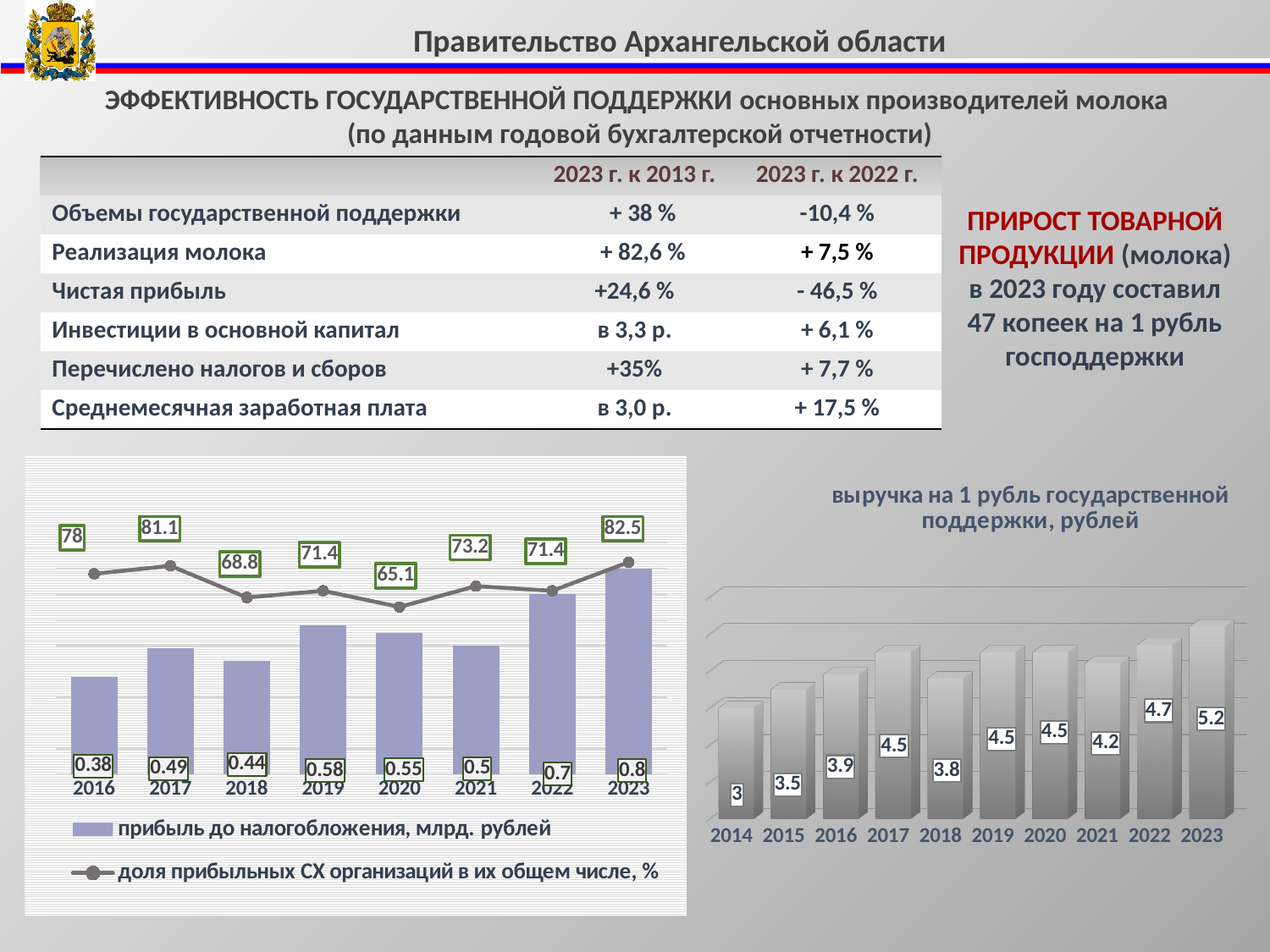
In the chart 'выручка на 1 рубль государственной поддержки, рублей', what is the value for 2018? 3.8 In the left chart, which year has the lowest 'доля прибыльных СХ организаций в их общем числе, %'? 2020 In the chart 'выручка на 1 рубль государственной поддержки, рублей', what is the difference between the values for 2023 and 2014? 2.2 In the chart 'выручка на 1 рубль государственной поддержки, рублей', is the value for 2022 larger or smaller than the value for 2021? larger How many series does the legend of the left chart list? 2 In the left chart, what is the value of 'доля прибыльных СХ организаций в их общем числе, %' for 2020? 65.1 In the left chart, what is the value of 'прибыль до налогообложения, млрд. рублей' for 2019? 0.58 In the left chart, what is the difference between the 'прибыль до налогообложения' values for 2023 and 2016? 0.42 In the chart 'выручка на 1 рубль государственной поддержки, рублей', how many years are shown? 10 In the left chart, which year has the highest 'прибыль до налогообложения, млрд. рублей'? 2023 In the chart 'выручка на 1 рубль государственной поддержки, рублей', which year has the lowest value? 2014 What type of chart is 'выручка на 1 рубль государственной поддержки, рублей'? bar chart